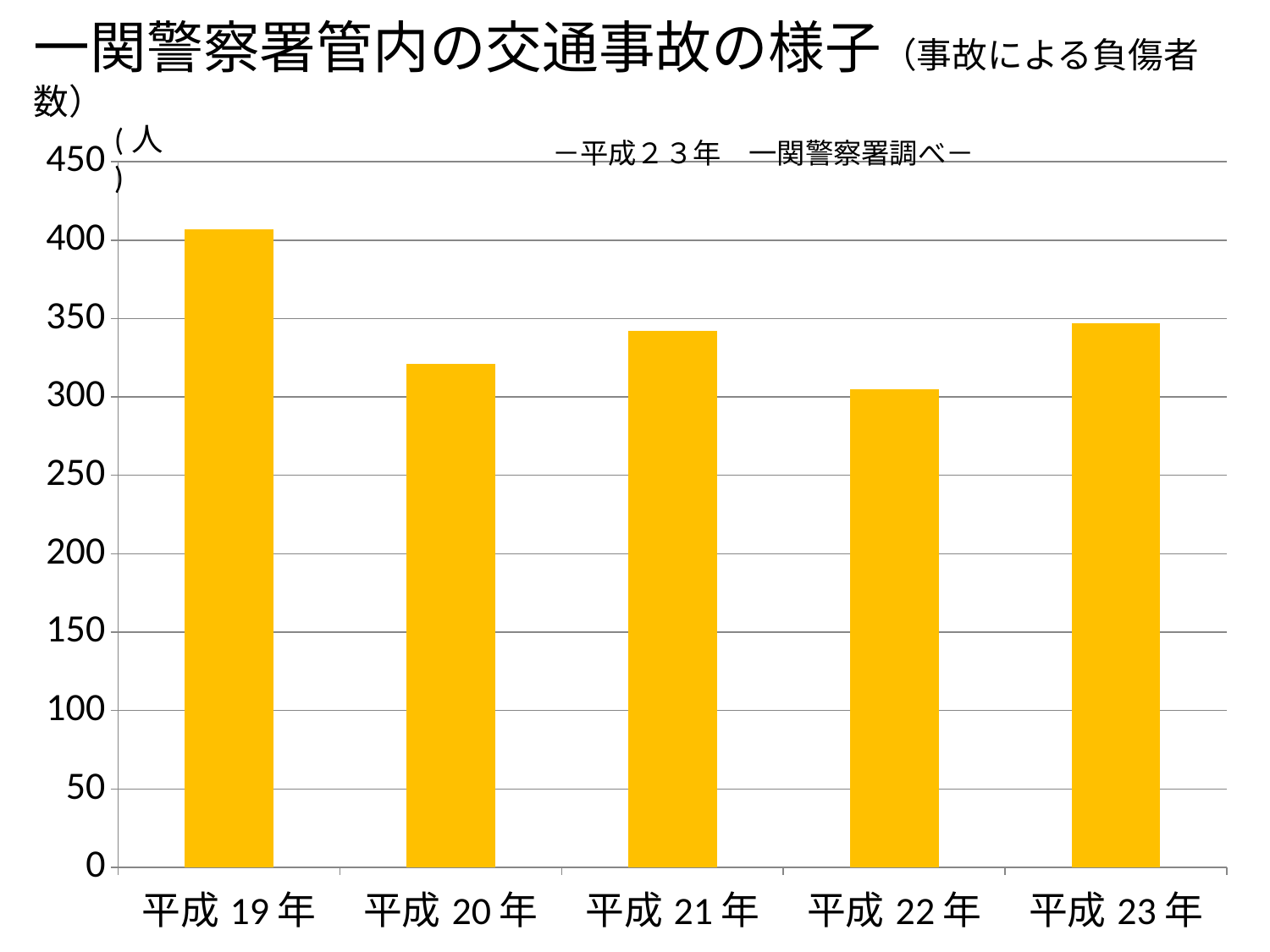
Is the value for 平成22年 greater or less than 350? less What unit is shown on the vertical axis of the chart? 人 Which year has the lowest number of injured persons? 平成22年 Which is larger, the value for 平成21年 or the value for 平成22年? 平成21年 Which is larger, the value for 平成19年 or the value for 平成20年? 平成19年 Is the value for 平成20年 greater or less than 300? greater Is the value for 平成23年 greater or less than 300? greater Which year has the highest number of injured persons? 平成19年 What kind of chart is shown on the slide? bar chart How many years (categories) are plotted on the chart? 5